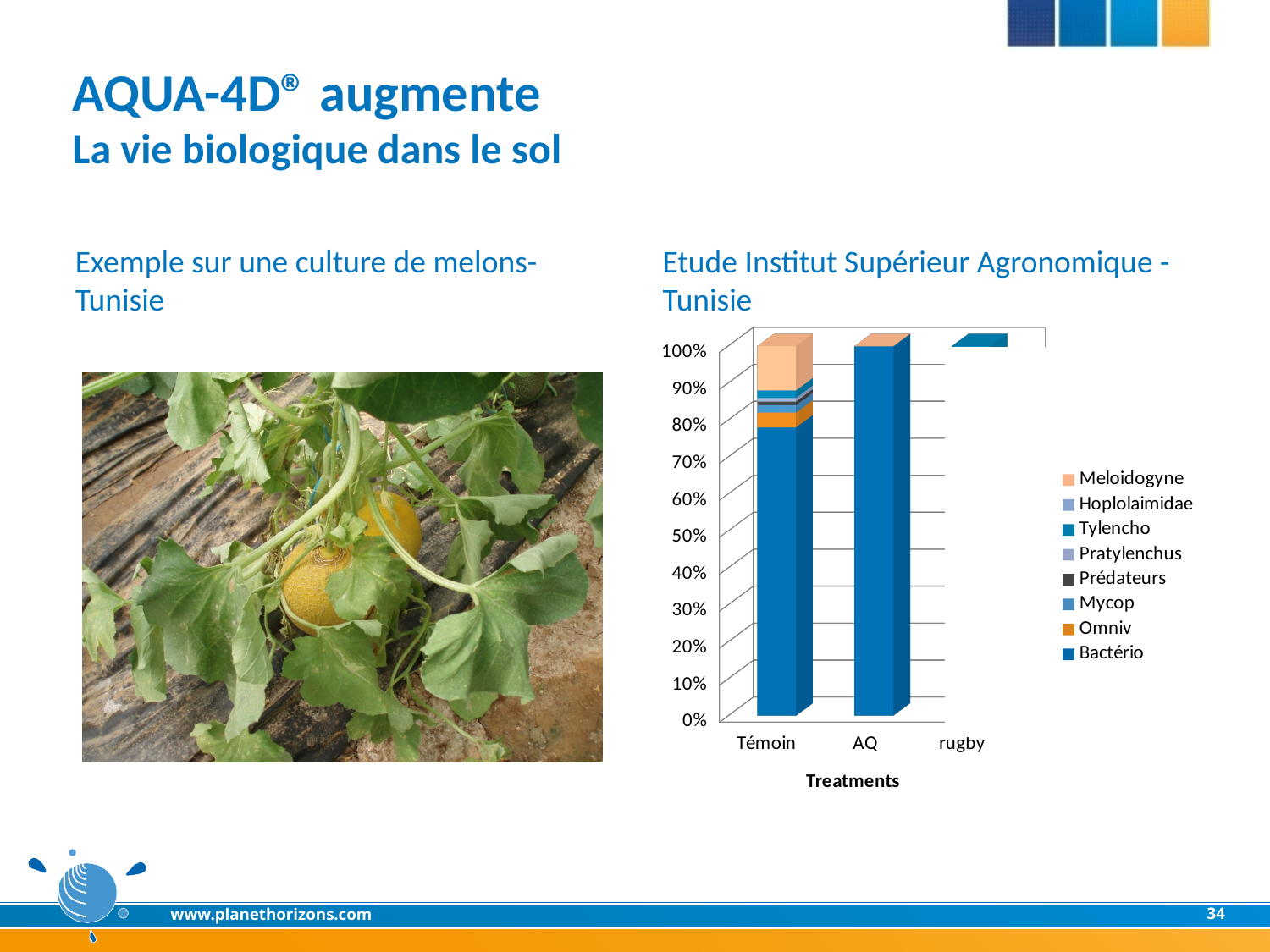
How many series does the chart legend list? 8 Which treatment has the largest Bactério segment in the chart? AQ Which series is listed last in the chart legend? Bactério What is the highest tick value shown on the y axis of the chart? 100% Which treatment category appears first on the x axis of the chart? Témoin Which treatment has the larger Bactério share, Témoin or AQ? AQ How many treatment categories are shown on the x axis of the chart? 3 What is the title of the x axis of the chart? Treatments Is the Bactério share for AQ greater or less than 90%? greater Is the Meloidogyne share for Témoin greater or less than 20%? less What kind of chart is shown on the slide? Stacked bar chart Is the Bactério share for Témoin greater or less than 70%? greater